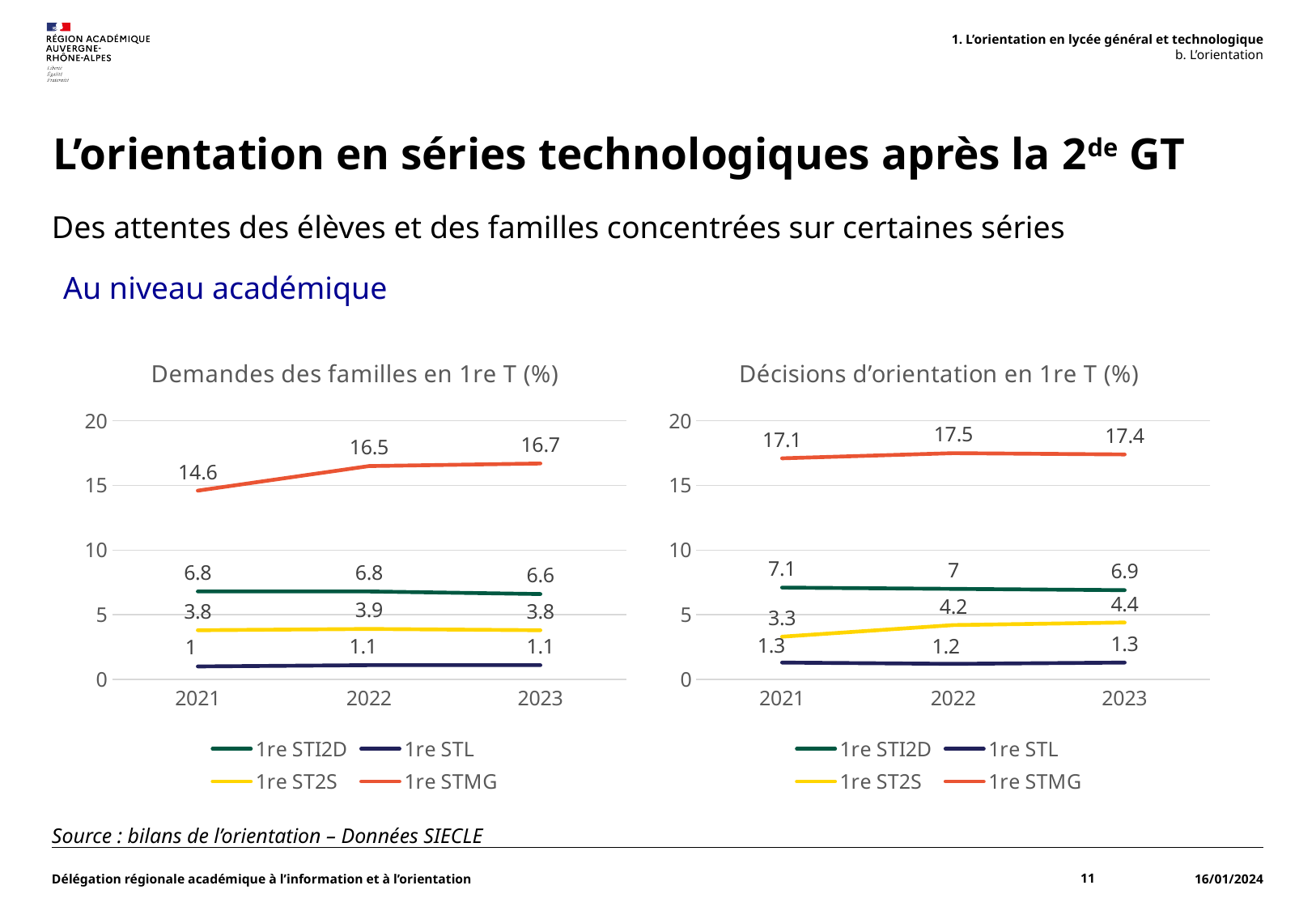
In the chart 'Demandes des familles en 1re T (%)', what is the difference between the 1re STMG values for 2023 and 2021? 2.1 In the chart 'Demandes des familles en 1re T (%)', which series has the lowest value in 2022? 1re STL How many series does the legend of the chart 'Décisions d'orientation en 1re T (%)' list? 4 In the chart 'Décisions d'orientation en 1re T (%)', what is the difference between 1re STI2D and 1re ST2S in 2021? 3.8 In the chart 'Demandes des familles en 1re T (%)', what is the value for 1re STL in 2021? 1 What kind of chart is 'Décisions d'orientation en 1re T (%)'? line chart In the chart 'Décisions d'orientation en 1re T (%)', which series has the highest value in 2023? 1re STMG How many years are shown on the x axis of the chart 'Demandes des familles en 1re T (%)'? 3 In the chart 'Décisions d'orientation en 1re T (%)', what is the value for 1re ST2S in 2023? 4.4 In the chart 'Demandes des familles en 1re T (%)', does the 1re STMG line rise or fall from 2021 to 2023? rise In the chart 'Demandes des familles en 1re T (%)', what is the value for 1re STMG in 2021? 14.6 In the chart 'Décisions d'orientation en 1re T (%)', is the value for 1re STI2D in 2022 larger or smaller than the value for 1re STI2D in 2022 in the chart 'Demandes des familles en 1re T (%)'? larger